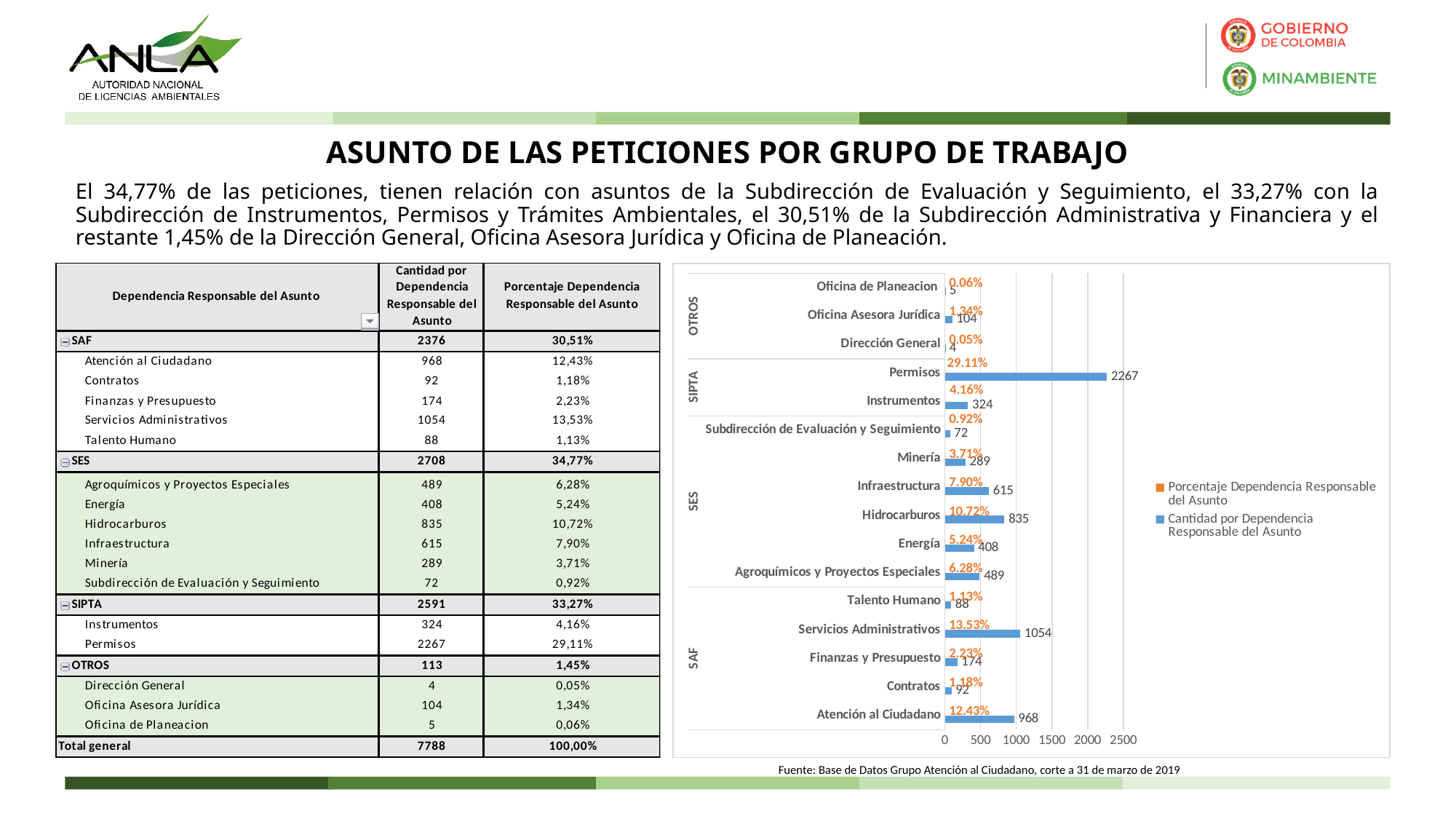
How many series does the chart legend list? 2 What is the Cantidad por Dependencia Responsable del Asunto value for Permisos in the chart? 2267 What colour are the Cantidad por Dependencia Responsable del Asunto bars in the chart? Blue What is the Cantidad value for Servicios Administrativos in the chart? 1054 Which category has the lowest Cantidad value in the chart? Dirección General Is the Cantidad value for Infraestructura greater or less than 500 in the chart? greater What percentage is shown for Hidrocarburos in the chart? 10.72% How many categories are plotted in the chart? 16 What is the difference in Cantidad between Permisos and Instrumentos in the chart? 1943 What kind of chart is shown on the slide? Bar chart Which category has the highest Cantidad value in the chart? Permisos Which has a larger Cantidad value in the chart, Atención al Ciudadano or Hidrocarburos? Atención al Ciudadano